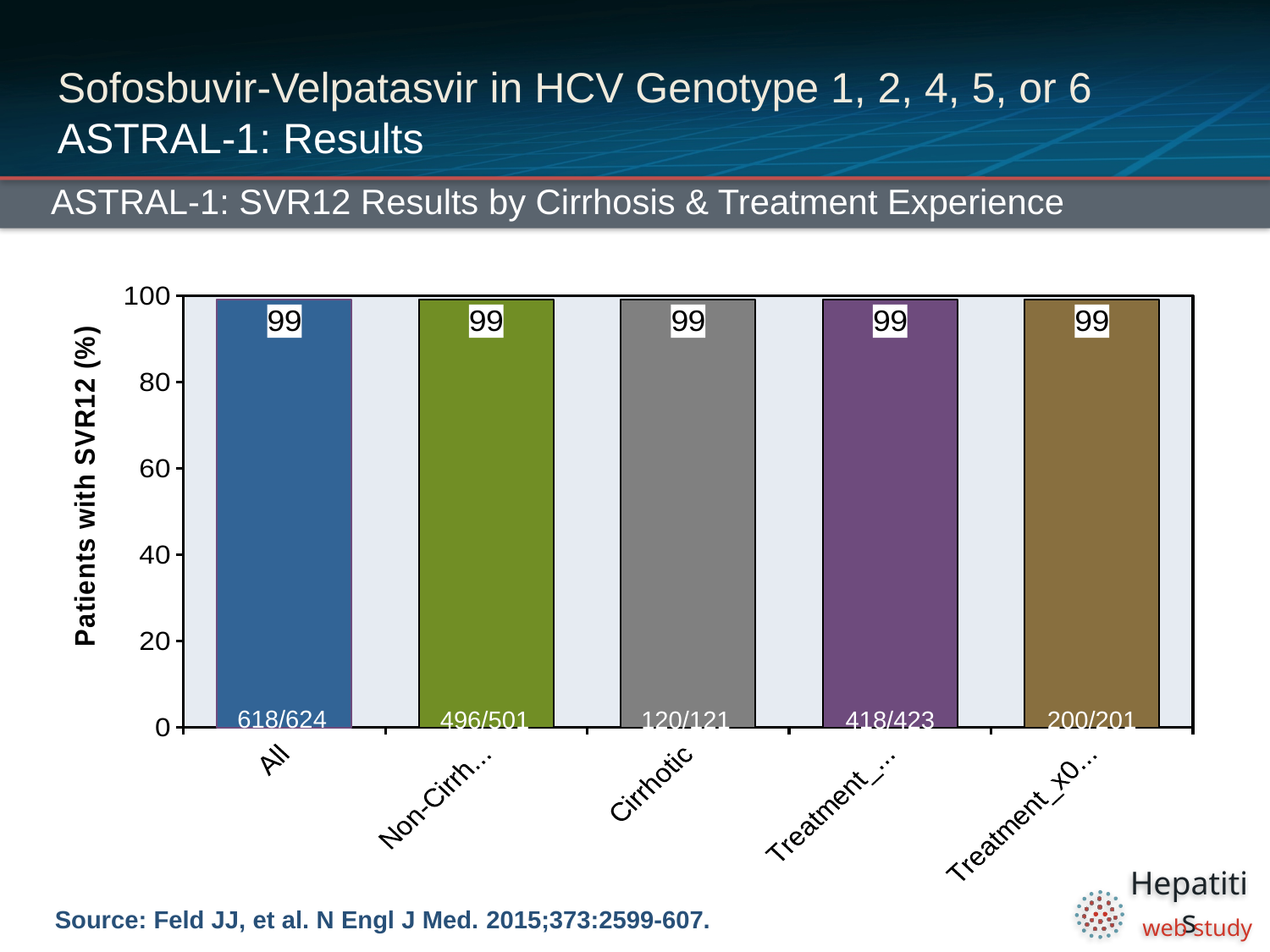
Is the value for the Cirrhotic category greater or less than 60? greater Is the value for the All category greater or less than 80? greater What kind of chart is shown on the slide? bar chart What is the SVR12 value shown for the Cirrhotic category? 99 What colour is the bar for the All category? blue What is the SVR12 value shown for the All category? 99 Do the bar values rise, fall, or stay flat from left to right across the chart? stay flat What is the difference between the SVR12 values for All and Cirrhotic? 0 What fraction of patients is printed at the base of the Cirrhotic bar? 120/121 What is the label on the vertical axis of the chart? Patients with SVR12 (%) How many bars are plotted in the chart? 5 What fraction of patients is printed at the base of the All bar? 618/624